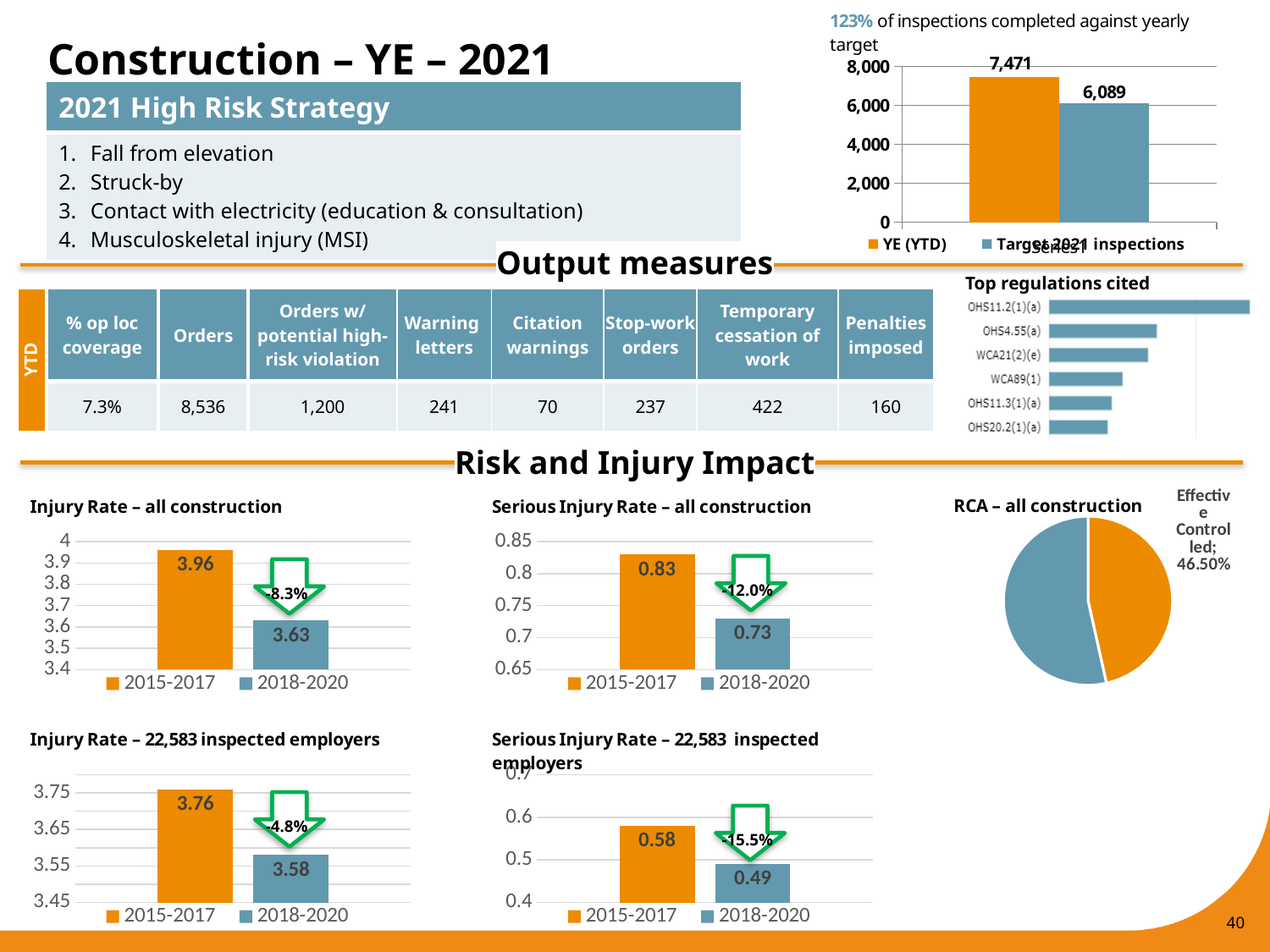
In the inspections chart at the top right, what is the value for Target 2021 inspections? 6,089 In the 'Serious Injury Rate – all construction' chart, which period has the higher value, 2015-2017 or 2018-2020? 2015-2017 In the inspections chart at the top right, what is the difference between YE (YTD) and Target 2021 inspections? 1,382 In the 'RCA – all construction' pie chart, what share is labelled Effective Controlled? 46.50% How many regulations are listed in the 'Top regulations cited' chart? 6 In the 'Injury Rate – 22,583 inspected employers' chart, what is the value for 2018-2020? 3.58 In the 'Serious Injury Rate – 22,583 inspected employers' chart, what is the value for 2015-2017? 0.58 In the 'Serious Injury Rate – all construction' chart, what is the difference between the 2015-2017 and 2018-2020 values? 0.10 In the inspections chart at the top right, what is the value for YE (YTD)? 7,471 In the 'Injury Rate – all construction' chart, what is the value for 2018-2020? 3.63 In the 'Top regulations cited' chart, which regulation has the longest bar? OHS11.2(1)(a) In the 'Injury Rate – all construction' chart, what is the value for 2015-2017? 3.96